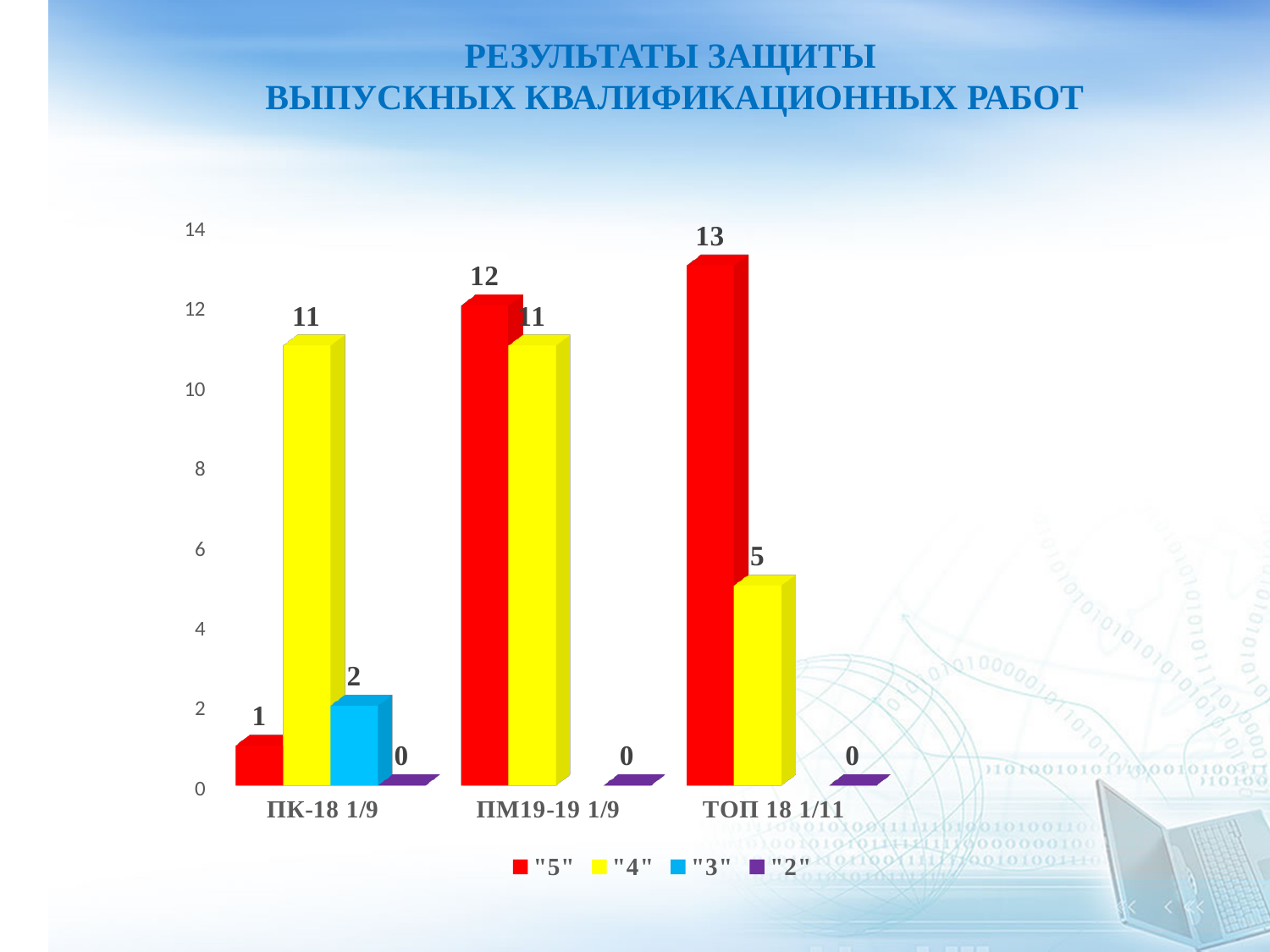
Which category has the lowest value for "4"? ТОП 18 1/11 How many series does the legend list? 4 Which is larger in the ПМ19-19 1/9 category: the value for "5" or the value for "4"? "5" How many categories are shown on the x axis? 3 Which category has the highest value for "5"? ТОП 18 1/11 What is the value for "4" in the ТОП 18 1/11 category? 5 What is the value for "4" in the ПК-18 1/9 category? 11 What is the difference between the "5" values for ТОП 18 1/11 and ПМ19-19 1/9? 1 What is the value for "3" in the ПК-18 1/9 category? 2 What is the value for "5" in the ПК-18 1/9 category? 1 What type of chart is shown on the slide? Bar chart What is the value for "5" in the ПМ19-19 1/9 category? 12